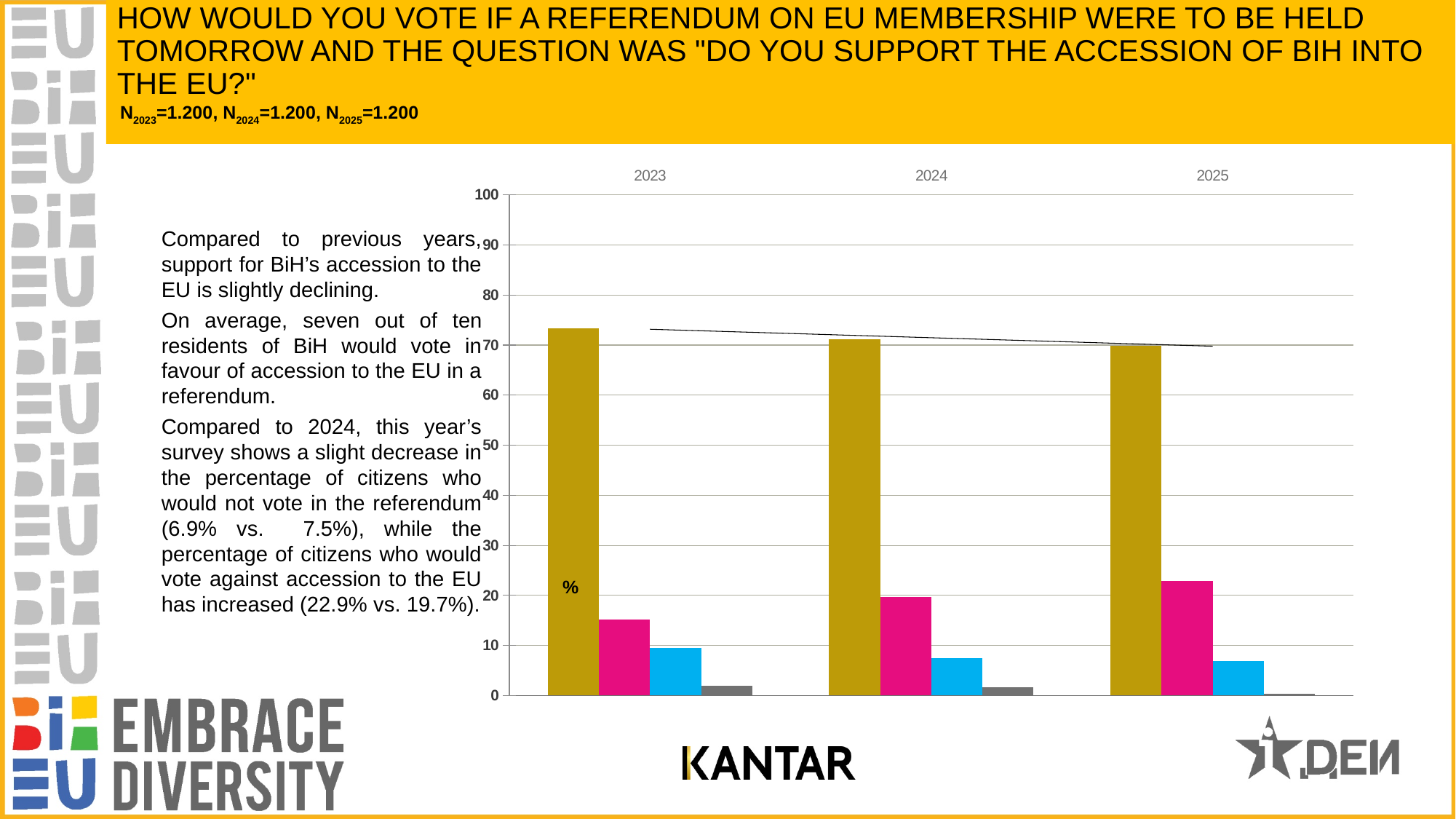
Is the value of the blue bar for 2024 greater or less than 10? less What is the highest value shown on the chart's vertical axis? 100 Which is larger: the pink bar for 2025 or the pink bar for 2023? the pink bar for 2025 Do the gold bars rise or fall from 2023 to 2025? fall Is the value of the pink bar for 2025 greater or less than 20? greater In which year is the pink bar the tallest? 2025 Is the value of the grey bar for 2023 greater or less than 10? less How many year categories are shown on the x axis of the chart? 3 Which years are shown as categories on the chart's x axis? 2023, 2024, 2025 What kind of chart is shown on the slide? bar chart